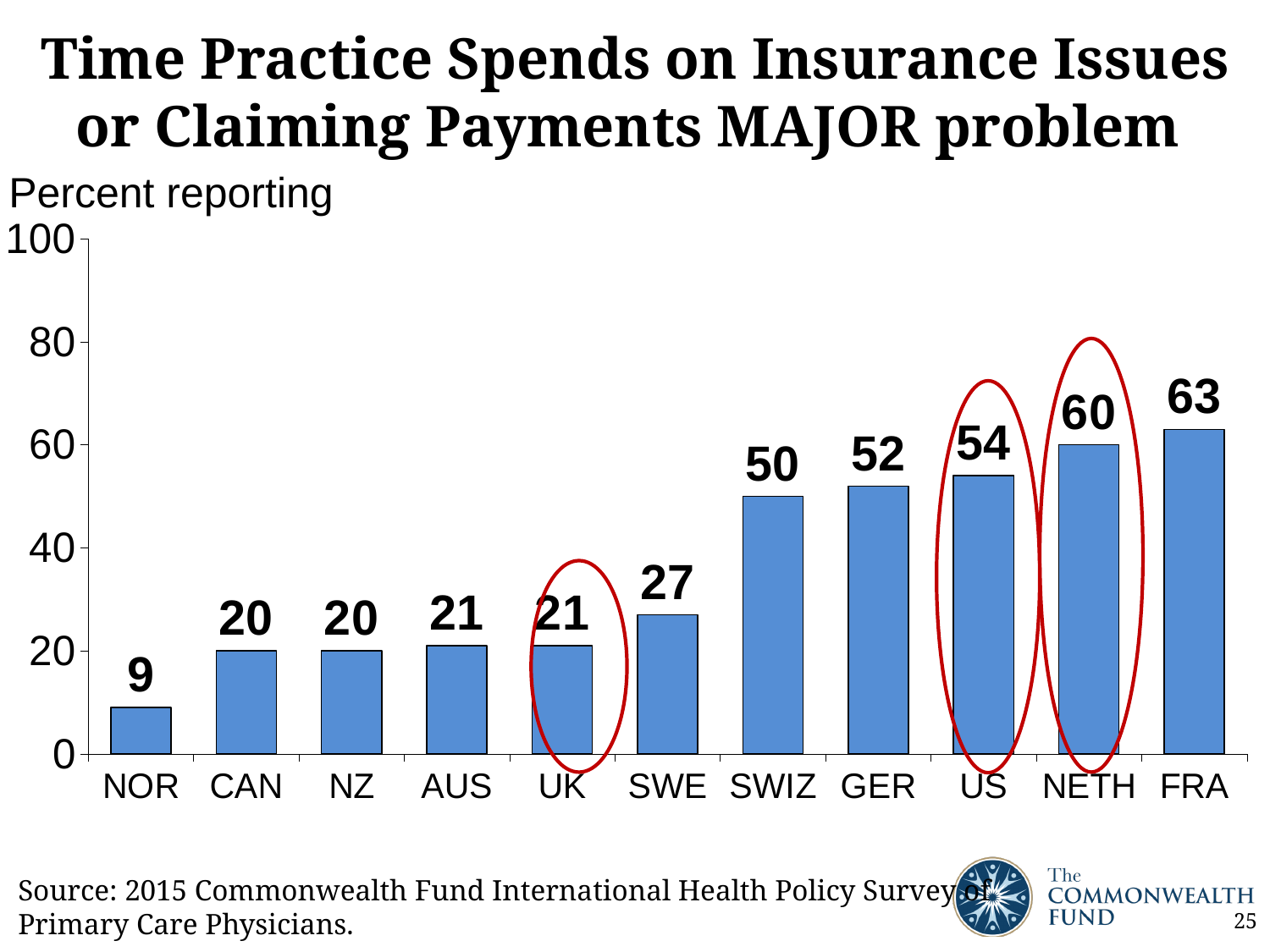
What is the value shown for SWE? 27 Which countries' bars are circled in red on the chart? UK, US, NETH What is the value shown for NOR? 9 Is the value for SWE greater or less than 40? less What kind of chart is shown on the slide? Bar chart What is the difference between the values for FRA and NOR? 54 Which country has the highest percent reporting? FRA How many countries are shown on the chart? 11 What is the difference between the values for NETH and US? 6 Which has a higher value, GER or SWIZ? GER What percent of practices in the US report time spent on insurance issues or claiming payments as a major problem? 54 Which country has the lowest percent reporting? NOR